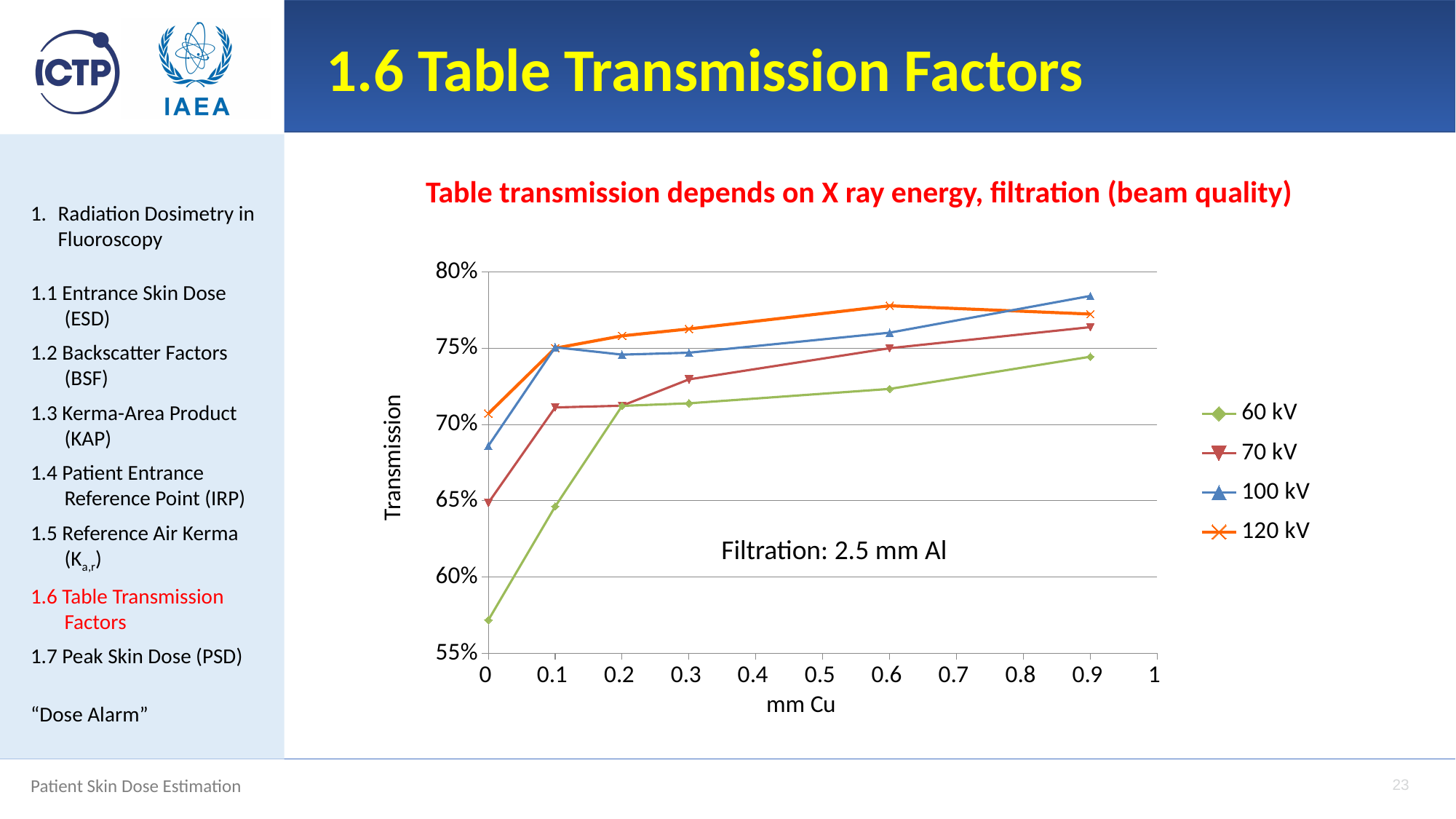
Does the transmission for 60 kV rise or fall as mm Cu increases? rise How many data points are plotted for the 60 kV series? 6 What is the label of the x axis? mm Cu Is the transmission for 60 kV at 0 mm Cu greater or less than 60%? less At 0.9 mm Cu, which has the higher transmission, 100 kV or 60 kV? 100 kV How many series does the legend list? 4 Which series has the lowest transmission at 0 mm Cu? 60 kV What kind of chart is shown on the slide? line chart Is the transmission for 70 kV at 0.3 mm Cu greater or less than 70%? greater Is the transmission for 120 kV at 0.6 mm Cu greater or less than 75%? greater Which series has the highest transmission at 0.6 mm Cu? 120 kV